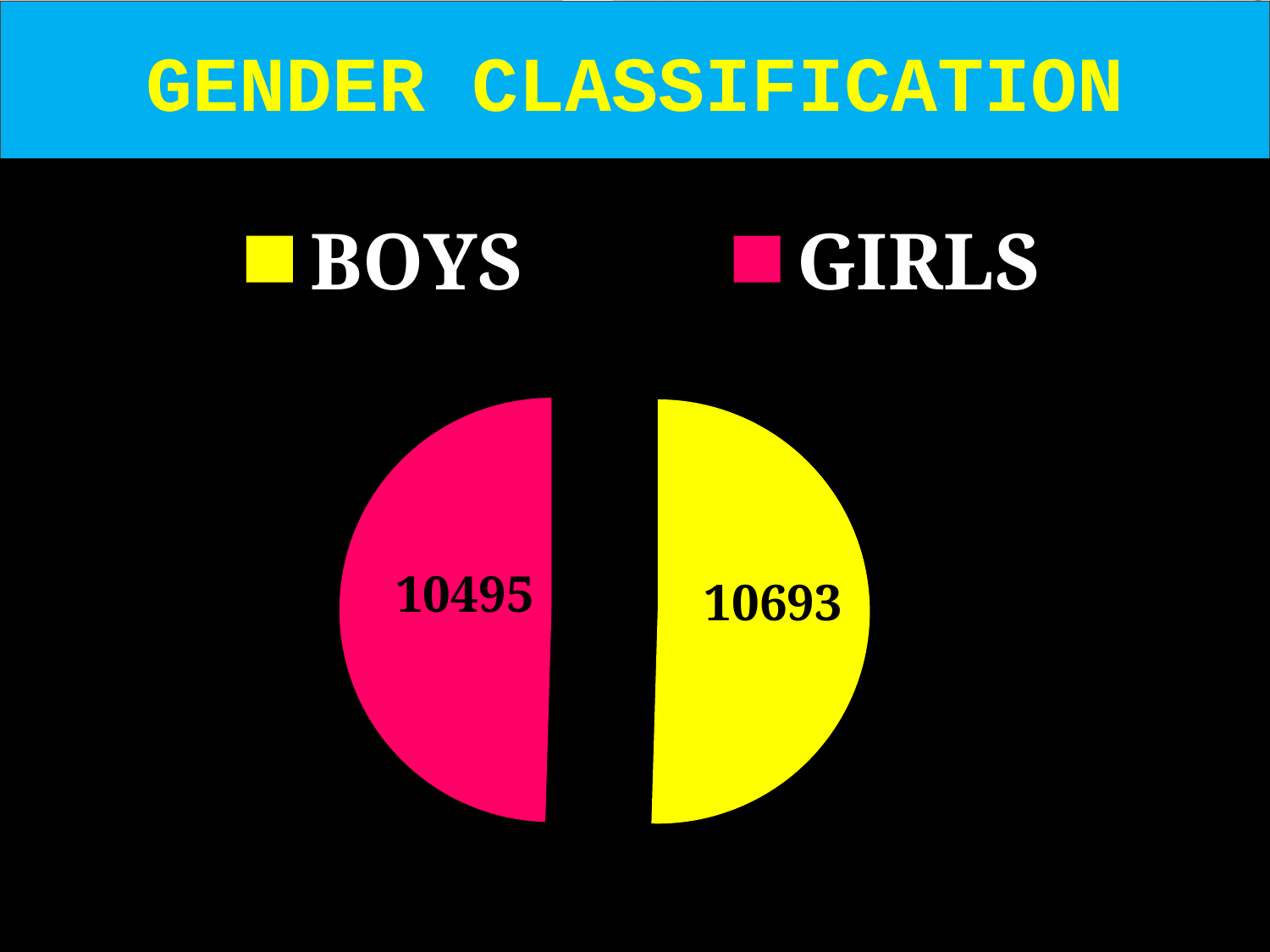
What is the value for BOYS in the pie chart? 10693 How many slices does the pie chart have? 2 What is the title of the slide containing the chart? GENDER CLASSIFICATION What is the difference between the BOYS value and the GIRLS value? 198 Which colour represents GIRLS in the pie chart? pink How many entries does the legend list? 2 What kind of chart is shown on the slide? pie chart Which category has the larger slice in the pie chart? BOYS What is the value for GIRLS in the pie chart? 10495 Which category has the smaller slice in the pie chart? GIRLS What is the total of the two slices in the pie chart? 21188 Is the value for BOYS larger or smaller than the value for GIRLS? larger